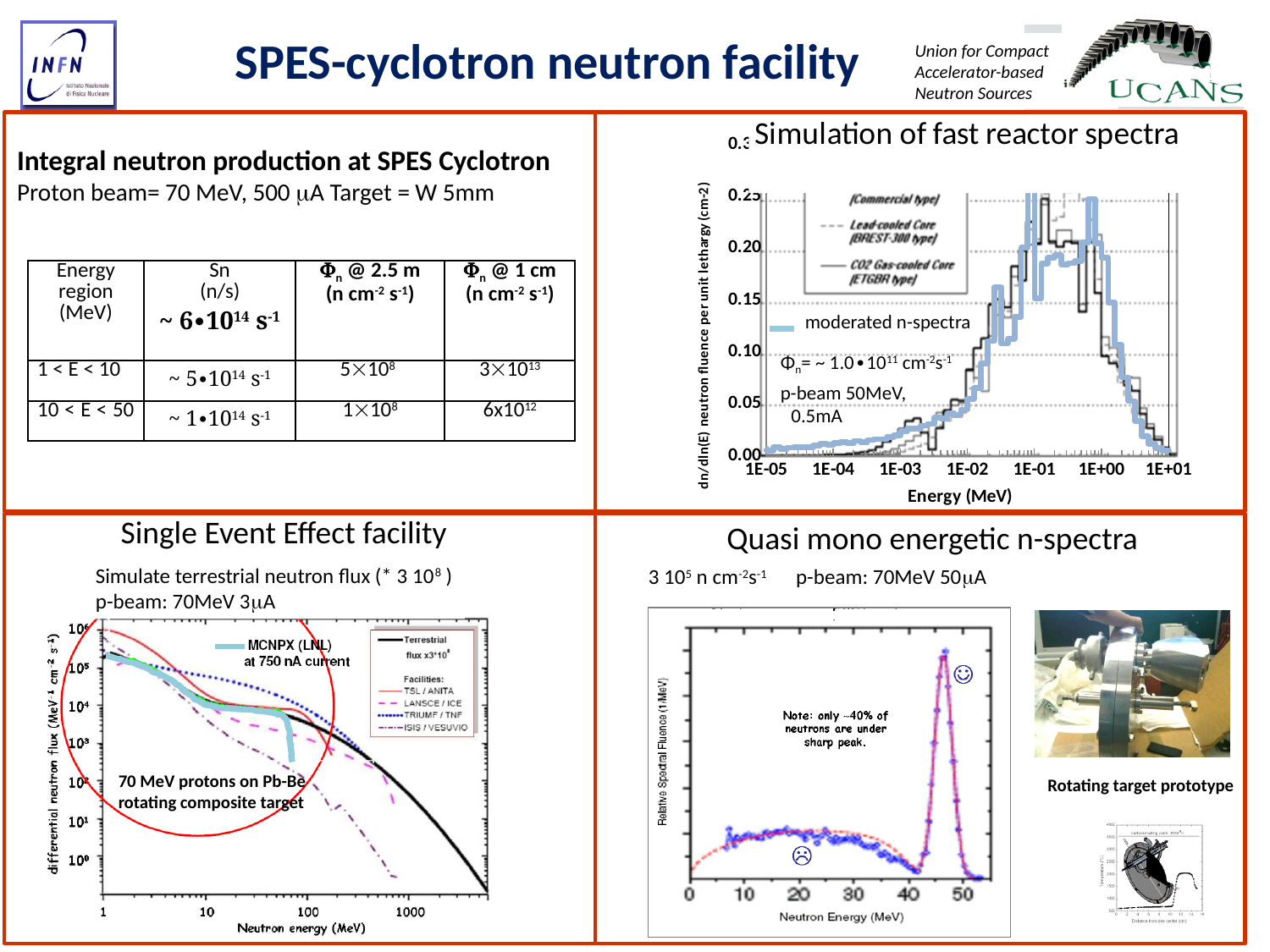
What kind of chart is the 'Simulation of fast reactor spectra' chart in the top right? line chart In the 'Single Event Effect facility' chart, how many facilities are listed under 'Facilities:' in the legend? 4 In the 'Simulation of fast reactor spectra' chart, is the value of the moderated n-spectra at 1E+01 MeV greater or less than 0.05? less In the 'Simulation of fast reactor spectra' chart, what is the label of the x axis? Energy (MeV) In the 'Single Event Effect facility' chart, at what current is the MCNPX (LNL) curve computed according to the legend? 750 nA In the 'Simulation of fast reactor spectra' chart, is the value of the moderated n-spectra at 1E-05 MeV greater or less than 0.05? less In the 'Simulation of fast reactor spectra' chart, what proton beam energy is stated in the annotation? 50MeV In the 'Simulation of fast reactor spectra' chart, how many series are listed in the legend box at the top of the plot? 3 In the 'Single Event Effect facility' chart in the bottom left, what is the label of the x axis? Neutron energy (MeV) In the 'Quasi mono energetic n-spectra' chart, what percentage of neutrons does the note say are under the sharp peak? ~40% In the 'Quasi mono energetic n-spectra' chart in the bottom right, is the sharp peak located at a neutron energy greater or less than 40 MeV? greater